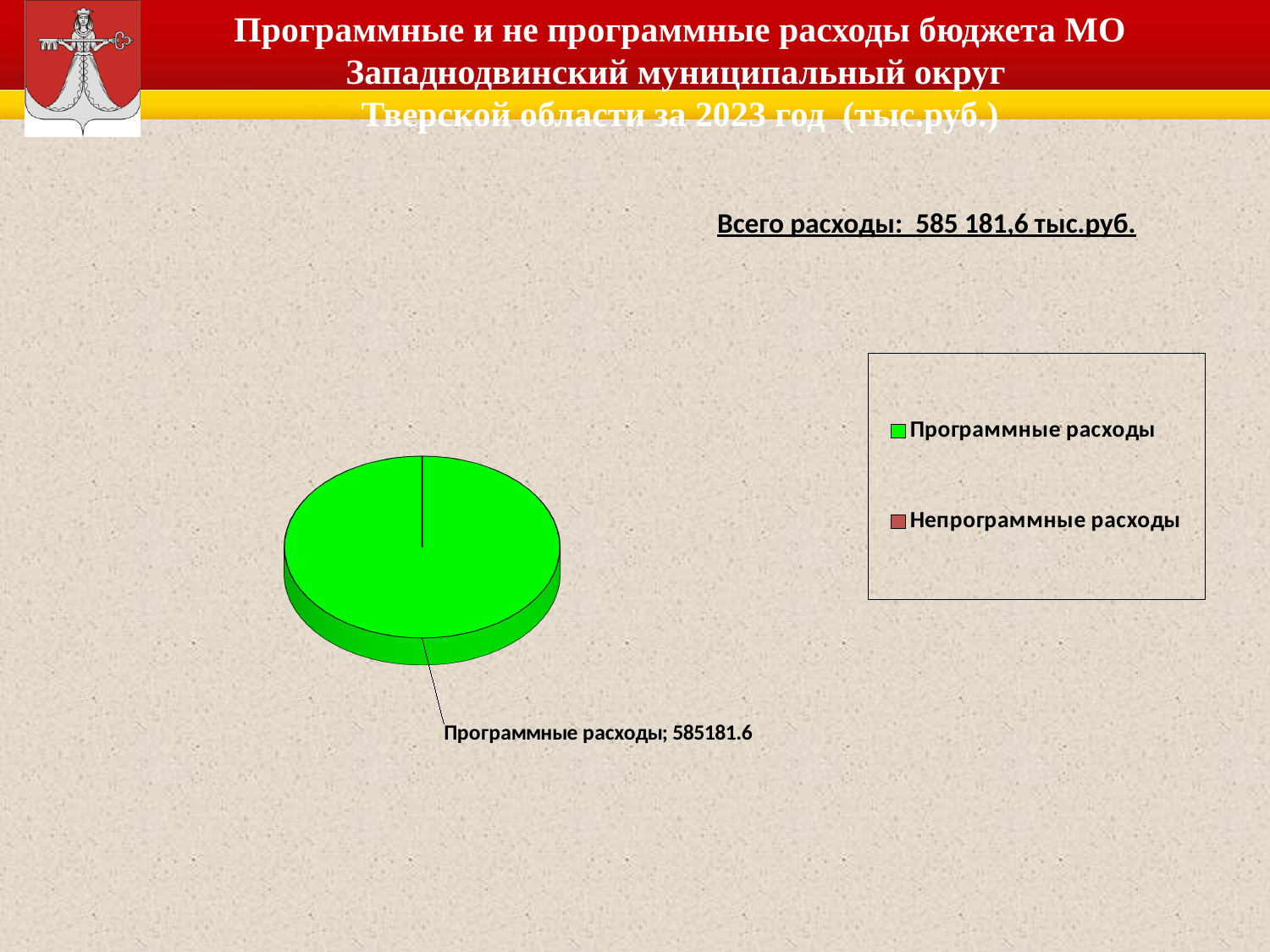
What kind of chart is shown on the slide? pie chart What share of the total expenditure does the Программные расходы slice represent? 100% What colour is used for Программные расходы in the pie chart? green Which category has the largest slice in the pie chart? Программные расходы What colour does the legend show for Непрограммные расходы? red How many entries does the legend of the pie chart list? 2 Which is larger in the pie chart: Программные расходы or Непрограммные расходы? Программные расходы What total expenditure is stated on the slide (Всего расходы)? 585 181,6 тыс.руб. Which category is the smallest in the pie chart? Непрограммные расходы What is the value shown for Программные расходы on the pie chart? 585181.6